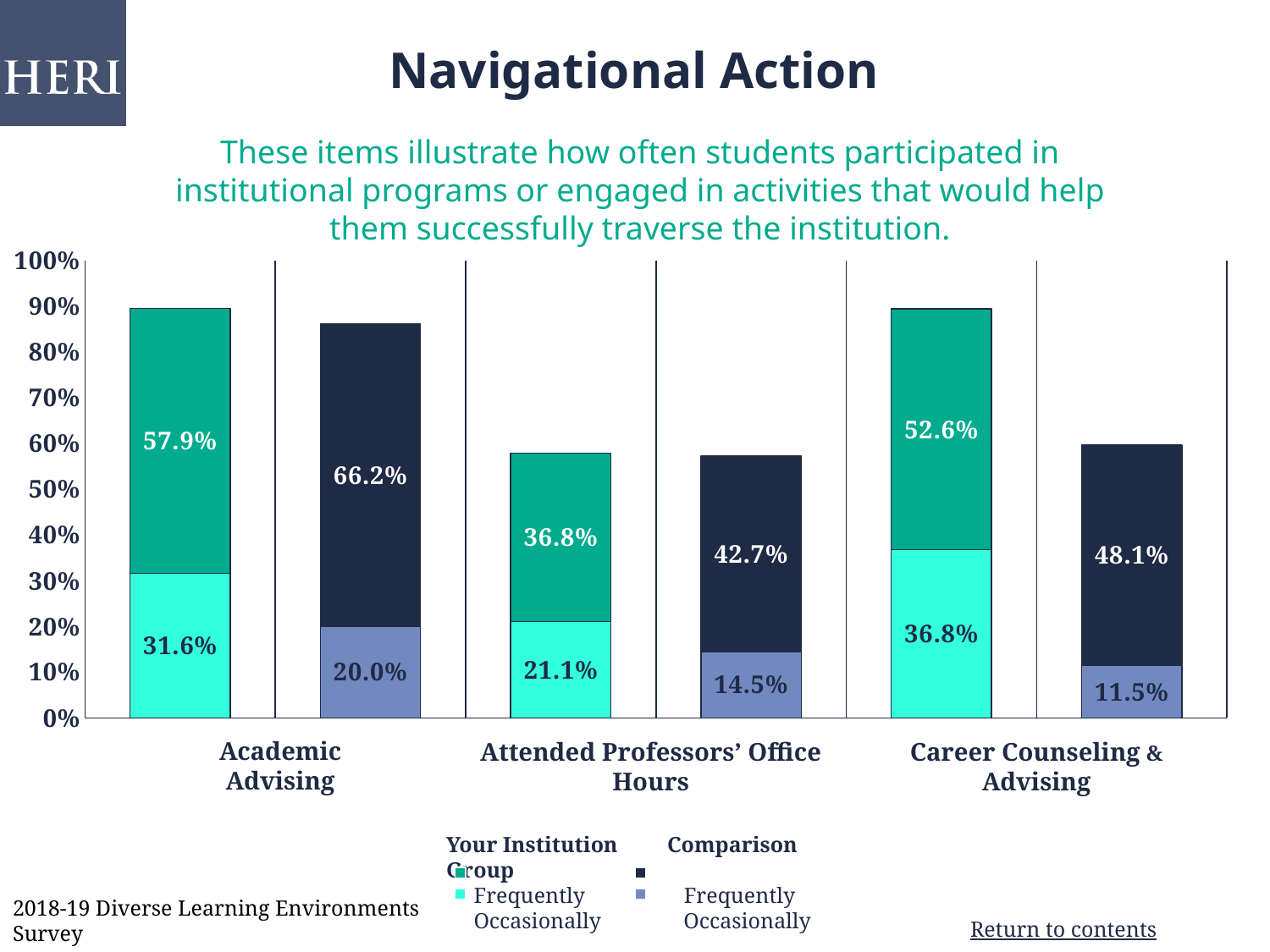
What percentage of Comparison Group students frequently used Career Counseling & Advising? 48.1% What is the difference between the Your Institution and Comparison Group 'Frequently' values for Career Counseling & Advising? 4.5 percentage points What is the total (Frequently plus Occasionally) for the Your Institution bar for Attended Professors' Office Hours? 57.9% What is the total (Frequently plus Occasionally) for the Comparison Group bar for Academic Advising? 86.2% Across the three items, which Comparison Group 'Frequently' value is the lowest? Attended Professors' Office Hours (42.7%) What percentage of Comparison Group students occasionally attended professors' office hours? 14.5% For Academic Advising, which group has the larger 'Occasionally' share: Your Institution or the Comparison Group? Your Institution What type of chart is shown on the slide? Stacked bar chart What percentage of students at Your Institution frequently used Academic Advising? 57.9% Which item has the highest 'Occasionally' value for the Comparison Group? Academic Advising (20.0%) What percentage of Your Institution students occasionally used Career Counseling & Advising? 36.8% How many activity categories are shown on the x axis? 3